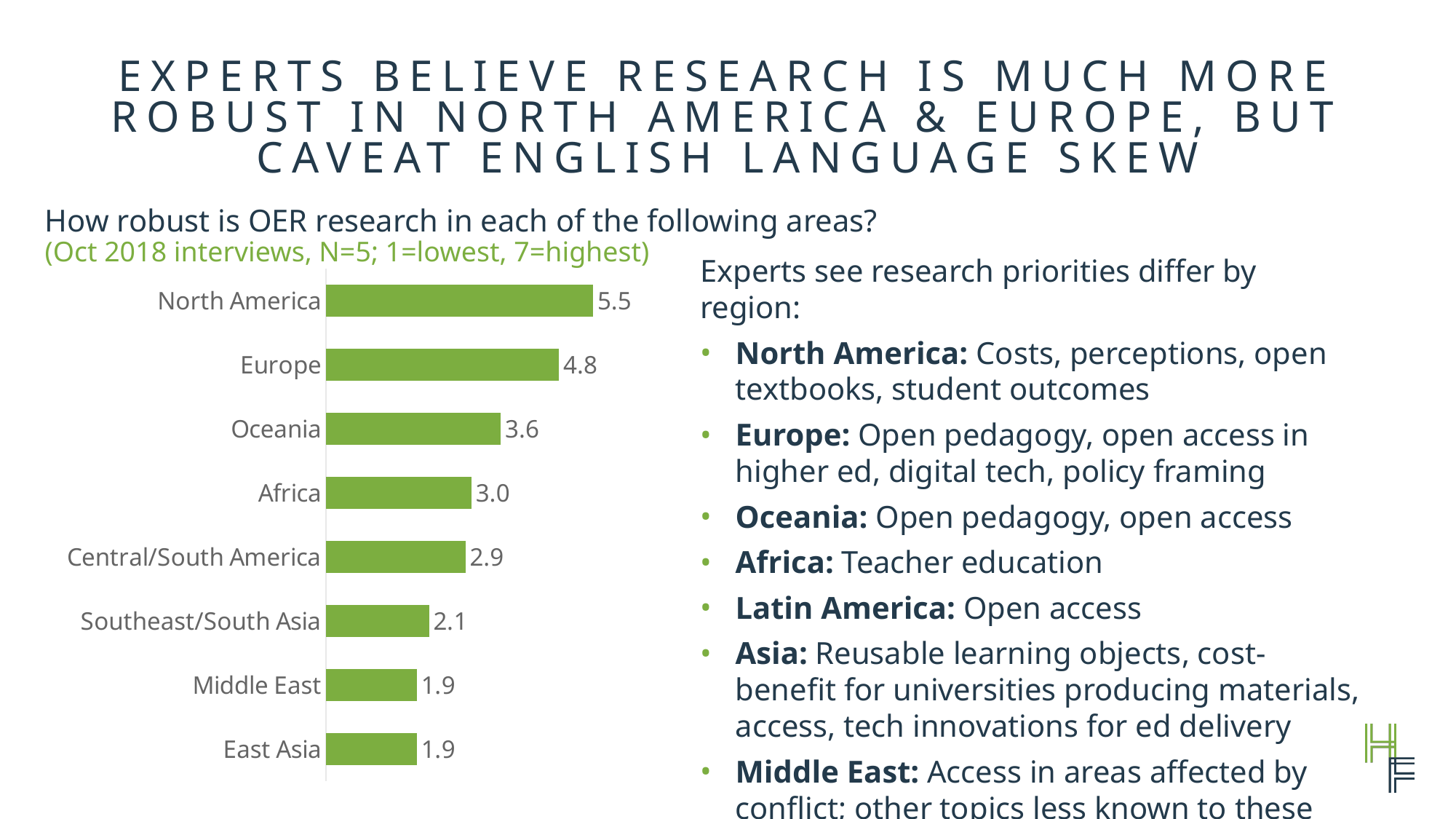
Which region has the highest value? North America What is the value for Central/South America? 2.9 Which is larger, the value for Europe or the value for Africa? Europe What is the value for Oceania? 3.6 What kind of chart is shown on the slide? Bar chart What is the value for North America? 5.5 Which two regions share the same value of 1.9? Middle East and East Asia What is the difference between the values for Oceania and Africa? 0.6 What is the value for Southeast/South Asia? 2.1 How many regions are shown in the chart? 8 What colour are the bars in the chart? Green What is the difference between the values for North America and Europe? 0.7